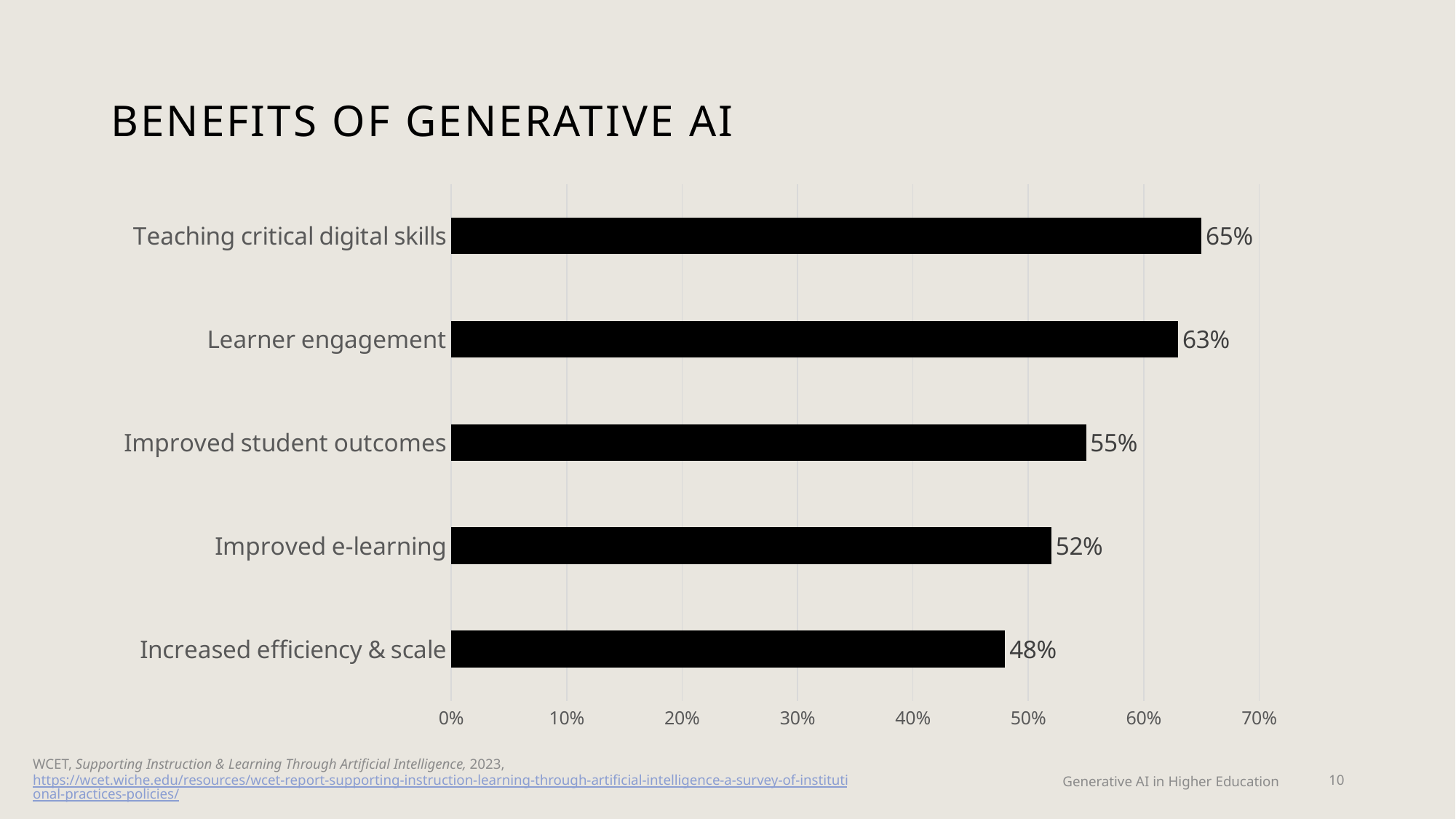
Which category has the highest value? Teaching critical digital skills What is the difference between the values for Improved student outcomes and Improved e-learning? 3% Which category has the lowest value? Increased efficiency & scale What is the value for Teaching critical digital skills? 65% Which is larger, the value for Improved e-learning or the value for Increased efficiency & scale? Improved e-learning What is the difference between the values for Teaching critical digital skills and Increased efficiency & scale? 17% What is the value for Increased efficiency & scale? 48% Is the value for Improved student outcomes greater or less than 50%? greater What is the value for Improved student outcomes? 55% What is the value for Learner engagement? 63% How many categories are shown in the chart? 5 What kind of chart is shown on the slide? Bar chart